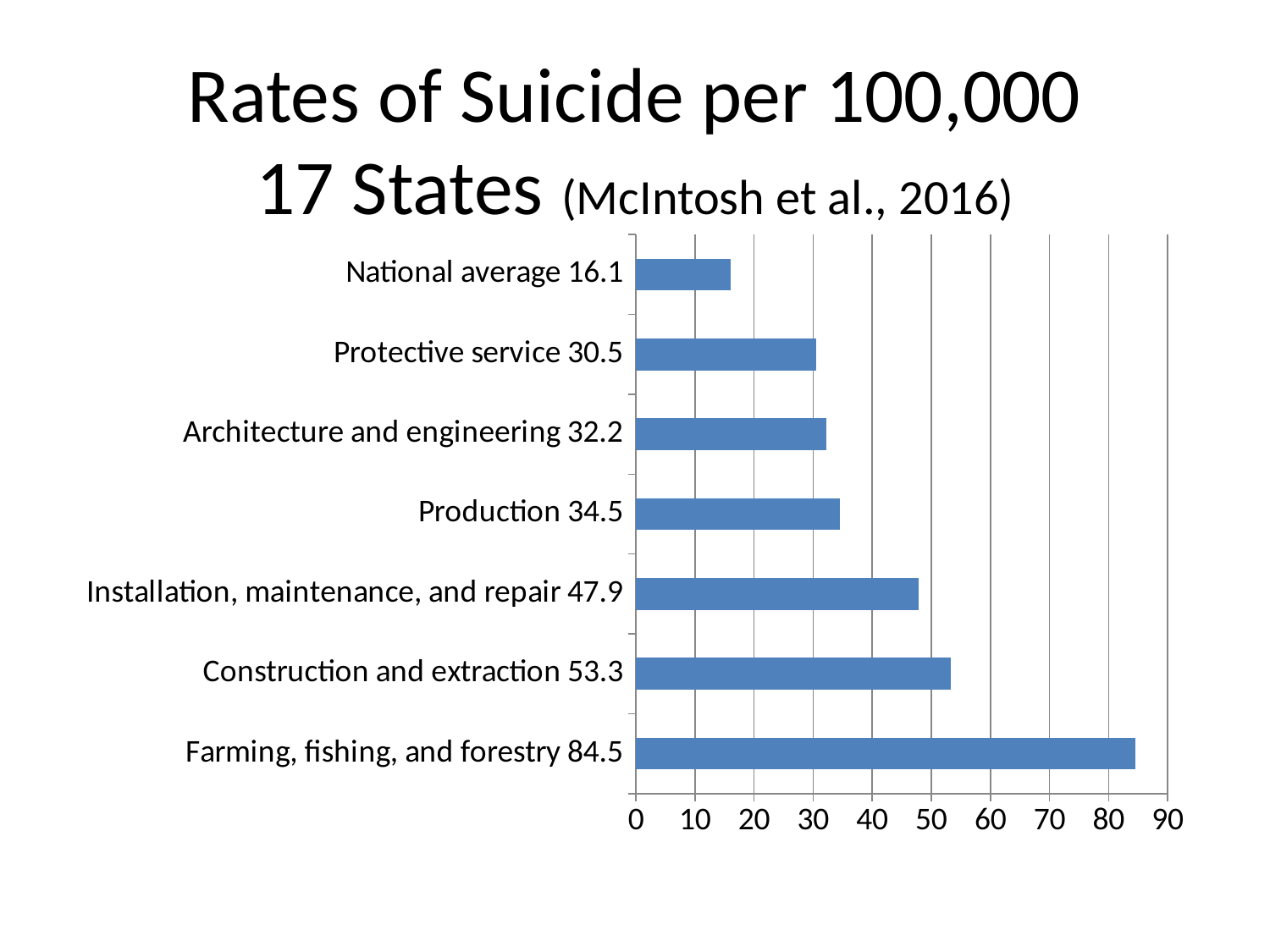
What kind of chart is shown on the slide? Bar chart What is the difference between the Farming, fishing, and forestry rate and the National average? 68.4 What is the suicide rate per 100,000 for Installation, maintenance, and repair? 47.9 Which has a higher suicide rate, Protective service or Production? Production What is the National average suicide rate per 100,000 shown on the chart? 16.1 Which category has the lowest value on the chart? National average Which category has the highest suicide rate? Farming, fishing, and forestry How many categories are shown on the chart? 7 What is the suicide rate per 100,000 for Construction and extraction? 53.3 Is the value for Construction and extraction greater or less than 50? greater What is the difference between the Construction and extraction rate and the Production rate? 18.8 What is the suicide rate per 100,000 for Farming, fishing, and forestry? 84.5